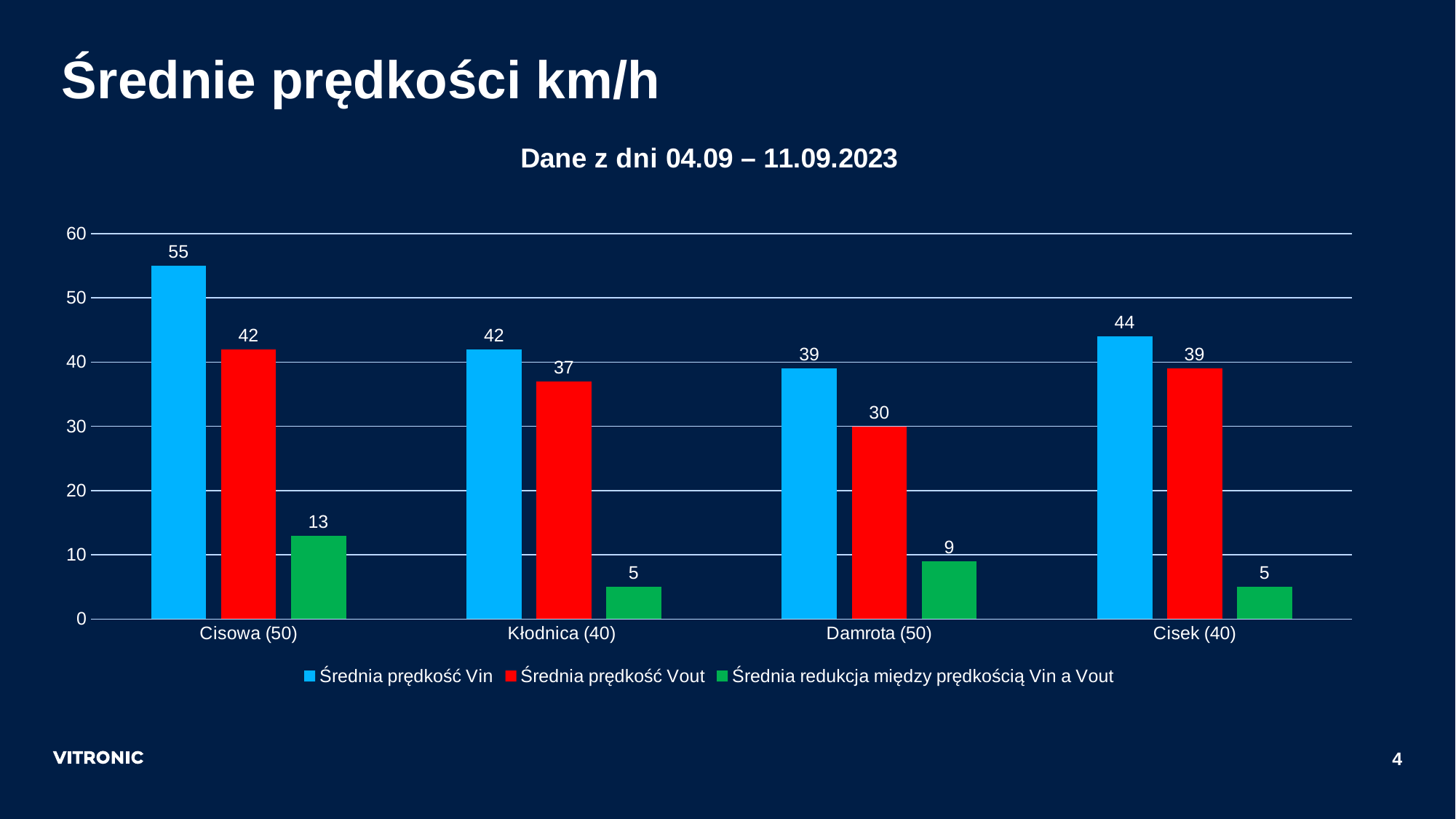
What is the chart's subtitle indicating the data period? Dane z dni 04.09 – 11.09.2023 Which location has the lowest Średnia prędkość Vout? Damrota (50) What is the Średnia prędkość Vout value for Damrota (50)? 30 How many locations are shown on the x axis? 4 What is the difference between Średnia prędkość Vin and Średnia prędkość Vout for Kłodnica (40)? 5 What is the Średnia redukcja między prędkością Vin a Vout value for Cisowa (50)? 13 Which colour represents Średnia prędkość Vout in the legend? red What is the Średnia prędkość Vin value for Cisowa (50)? 55 Which is larger: Średnia prędkość Vin for Cisek (40) or Średnia prędkość Vin for Kłodnica (40)? Cisek (40) Which location has the highest Średnia prędkość Vin? Cisowa (50) What kind of chart is shown on the slide? bar chart How many series does the legend list? 3